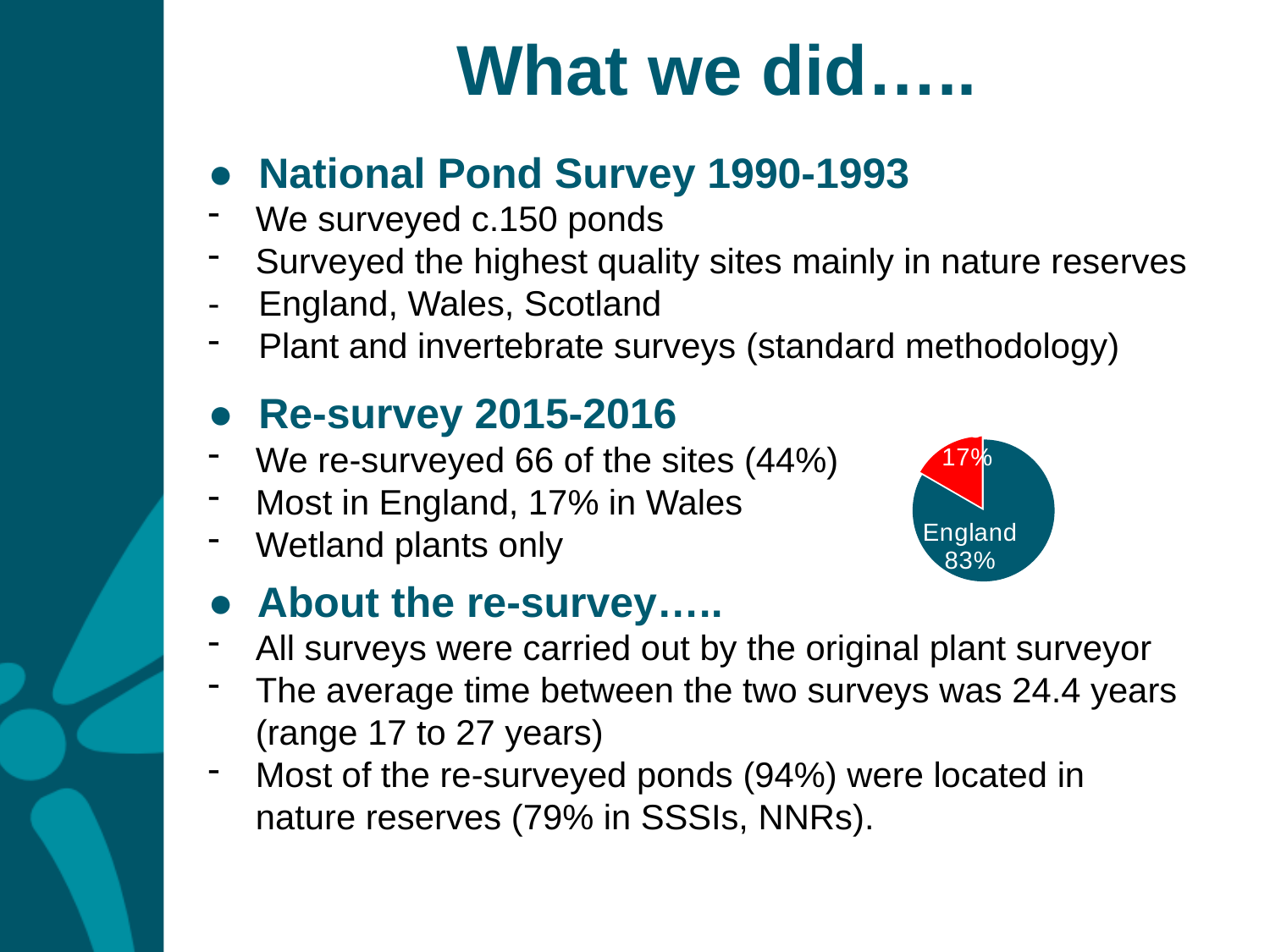
What kind of chart is shown on the slide? pie chart Which slice of the pie chart is the smallest? the red 17% slice Is the England slice of the pie chart greater or less than 50%? greater Which is larger in the pie chart, the England slice or the red slice? England Which slice of the pie chart is the largest? England What do the two slices of the pie chart add up to? 100% What colour is the 17% slice of the pie chart? red What is the difference in percentage points between the England slice and the 17% slice? 66 What share of the pie chart is labelled England? 83% What percentage is shown on the red slice of the pie chart? 17% How many slices does the pie chart have? 2 What colour is the England slice of the pie chart? dark teal